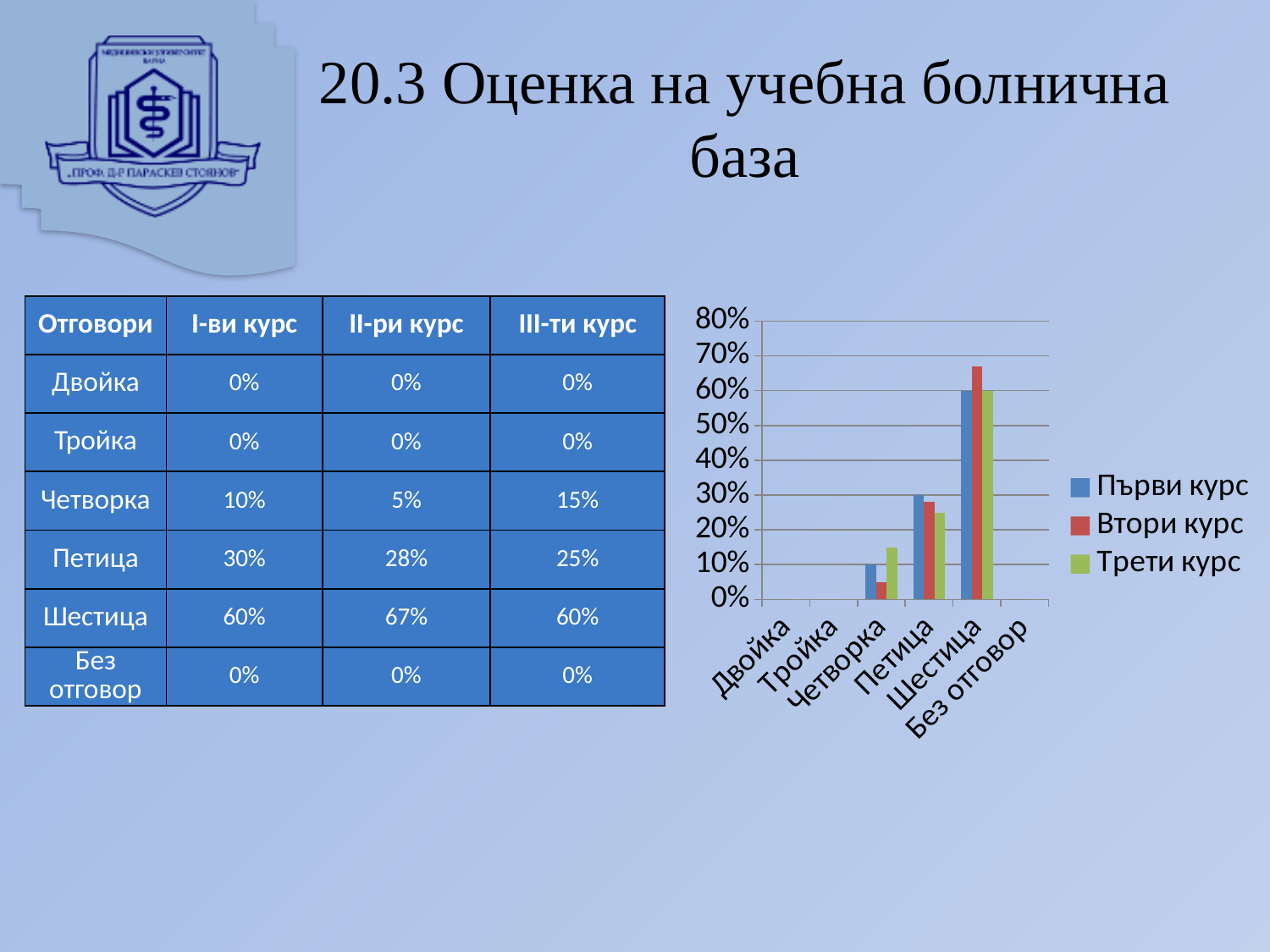
Which series has the highest value for Шестица? Втори курс What is the value for Четворка in the Трети курс series? 15% What is the difference between the Втори курс and Първи курс values for Шестица? 7% What is the value for Петица in the Първи курс series? 30% Which series is shown in green in the chart legend? Трети курс Which category has the highest value in the Първи курс series? Шестица How many series does the chart legend list? 3 How many categories are shown on the x axis of the chart? 6 What is the value for Шестица in the Втори курс series? 67% Is the value for Шестица in the Втори курс series greater or less than 60%? greater Which is larger for Четворка: the Първи курс value or the Втори курс value? Първи курс What kind of chart is shown on the slide? bar chart